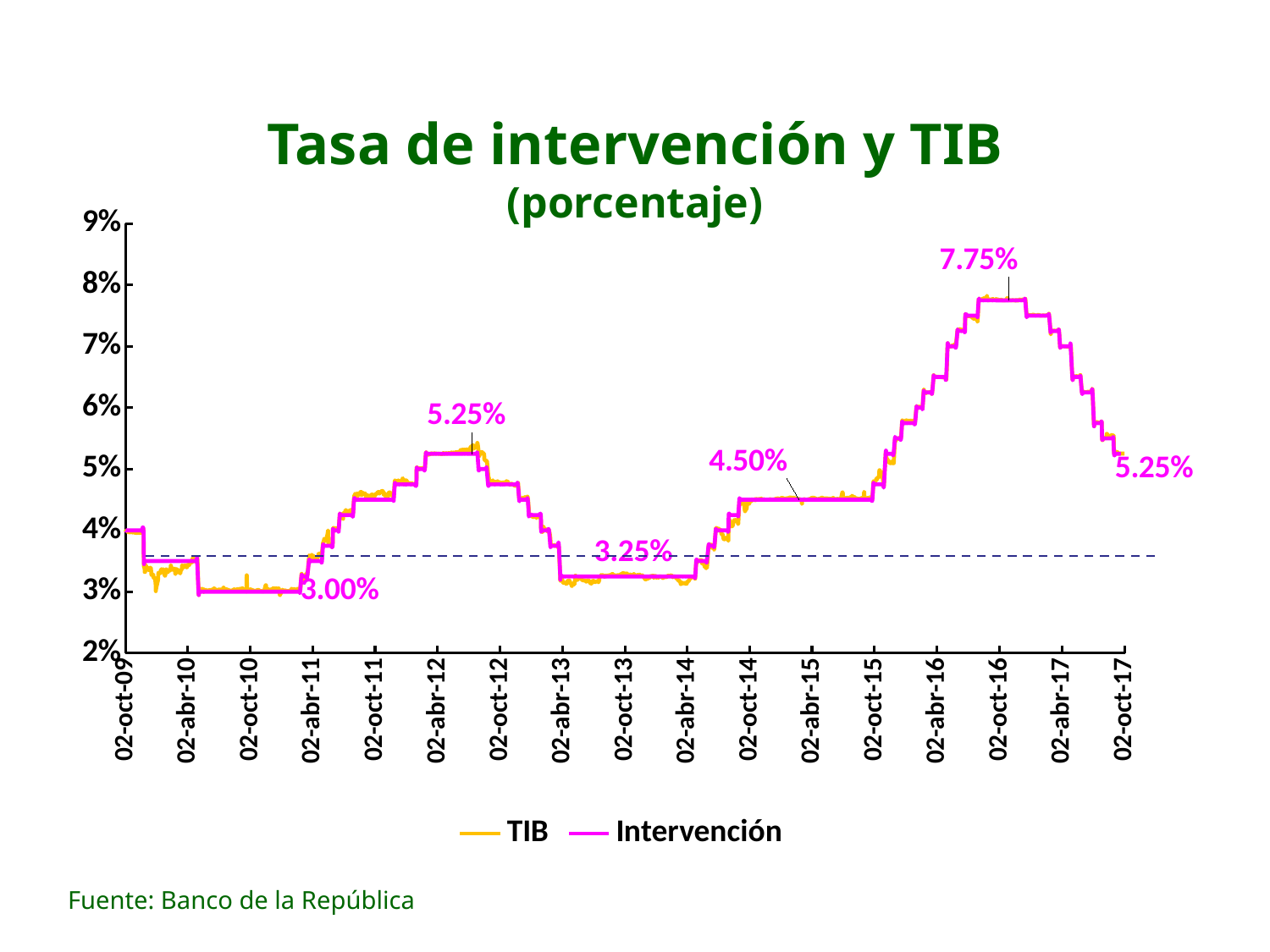
What are the two series named in the legend? TIB and Intervención Is the Intervención rate at 02-oct-10 greater or less than 4%? less What is the labeled value of the Intervención rate during the plateau between 02-abr-13 and 02-abr-14? 3.25% What is the labeled value of the Intervención rate during the plateau around 02-abr-15? 4.50% What is the difference between the labeled peak of 7.75% and the labeled plateau of 4.50%? 3.25 percentage points What is the labeled value of the Intervención rate at its plateau around 02-abr-12? 5.25% What is the title of the chart? Tasa de intervención y TIB (porcentaje) How many series does the legend list? 2 What is the labeled peak value of the Intervención rate reached around 02-oct-16? 7.75% What is the lowest labeled value of the Intervención rate on the chart? 3.00% Between 02-abr-15 and 02-oct-16, does the Intervención rate rise or fall? rise What kind of chart is shown on the slide? line chart